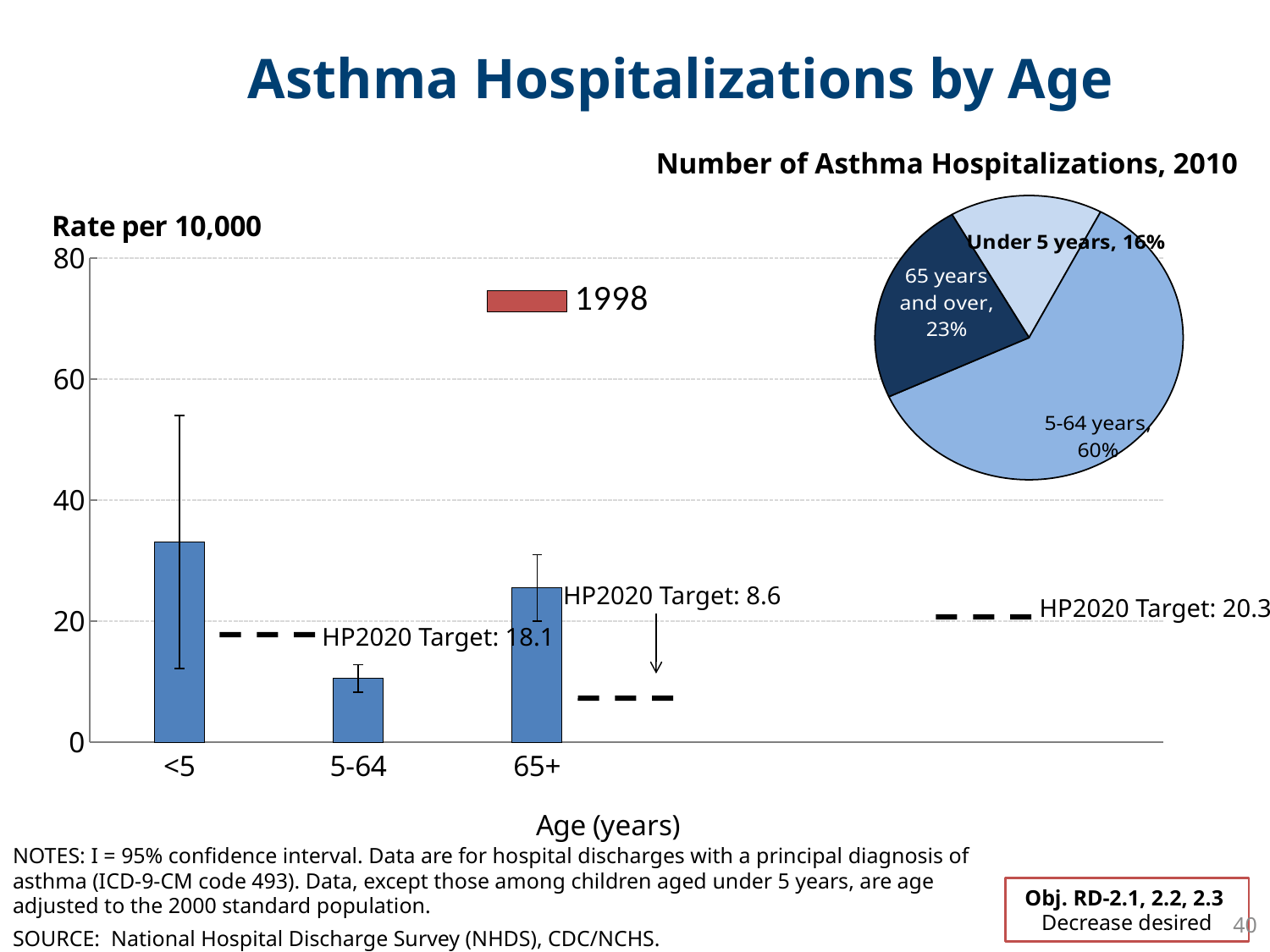
In the pie chart titled 'Number of Asthma Hospitalizations, 2010', how many slices are there? 3 In the pie chart titled 'Number of Asthma Hospitalizations, 2010', what share is shown for 65 years and over? 23% In the pie chart titled 'Number of Asthma Hospitalizations, 2010', what share is shown for 5-64 years? 60% In the pie chart titled 'Number of Asthma Hospitalizations, 2010', how many percentage points larger is the 5-64 years share than the 65 years and over share? 37 percentage points In the pie chart titled 'Number of Asthma Hospitalizations, 2010', which age group has the largest slice? 5-64 years In the pie chart titled 'Number of Asthma Hospitalizations, 2010', which age group has the smallest slice? Under 5 years In the bar chart on the left, which age group has the highest rate per 10,000? <5 In the bar chart on the left, is the rate for the 5-64 age group greater or less than 20? less In the bar chart on the left, what is the HP2020 Target shown for the <5 age group? 18.1 What kind of chart is the 'Rate per 10,000' chart on the left of the slide? Bar chart In the pie chart titled 'Number of Asthma Hospitalizations, 2010', what share is shown for Under 5 years? 16% In the bar chart on the left, how many age categories are shown on the x axis? 3